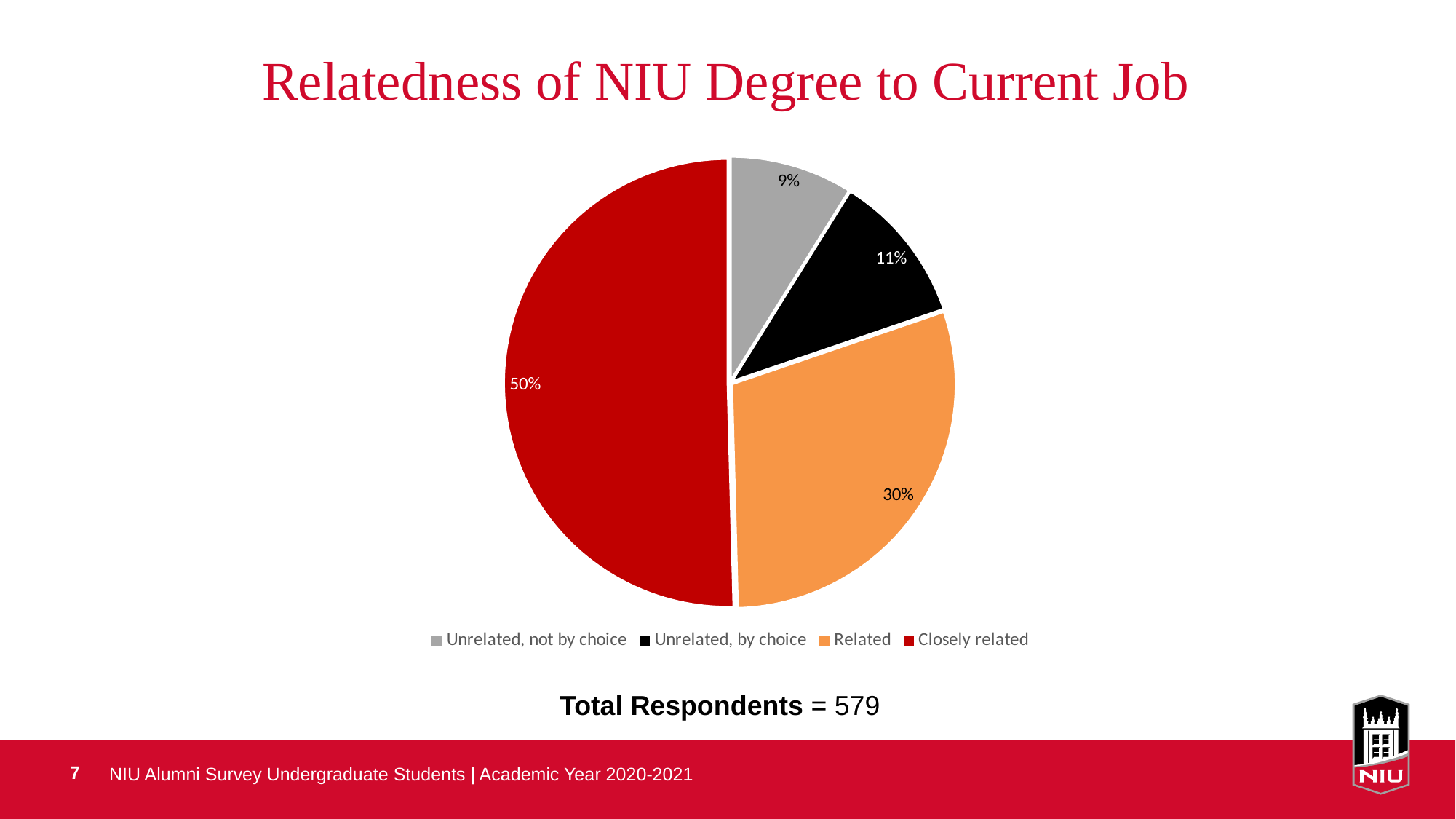
What percentage of respondents said their NIU degree is related to their current job? 30% What colour is the 'Related' slice? orange Which category has the smallest share of the pie? Unrelated, not by choice Which is larger, the share for 'Unrelated, by choice' or 'Unrelated, not by choice'? Unrelated, by choice What percentage of respondents chose 'Unrelated, not by choice'? 9% What is the difference in percentage points between 'Closely related' and 'Related'? 20 What is the total number of respondents stated on the slide? 579 Which category has the largest share of the pie? Closely related What percentage of respondents said their NIU degree is closely related to their current job? 50% What percentage of respondents chose 'Unrelated, by choice'? 11% How many categories does the pie chart have? 4 What type of chart is shown on the slide? pie chart